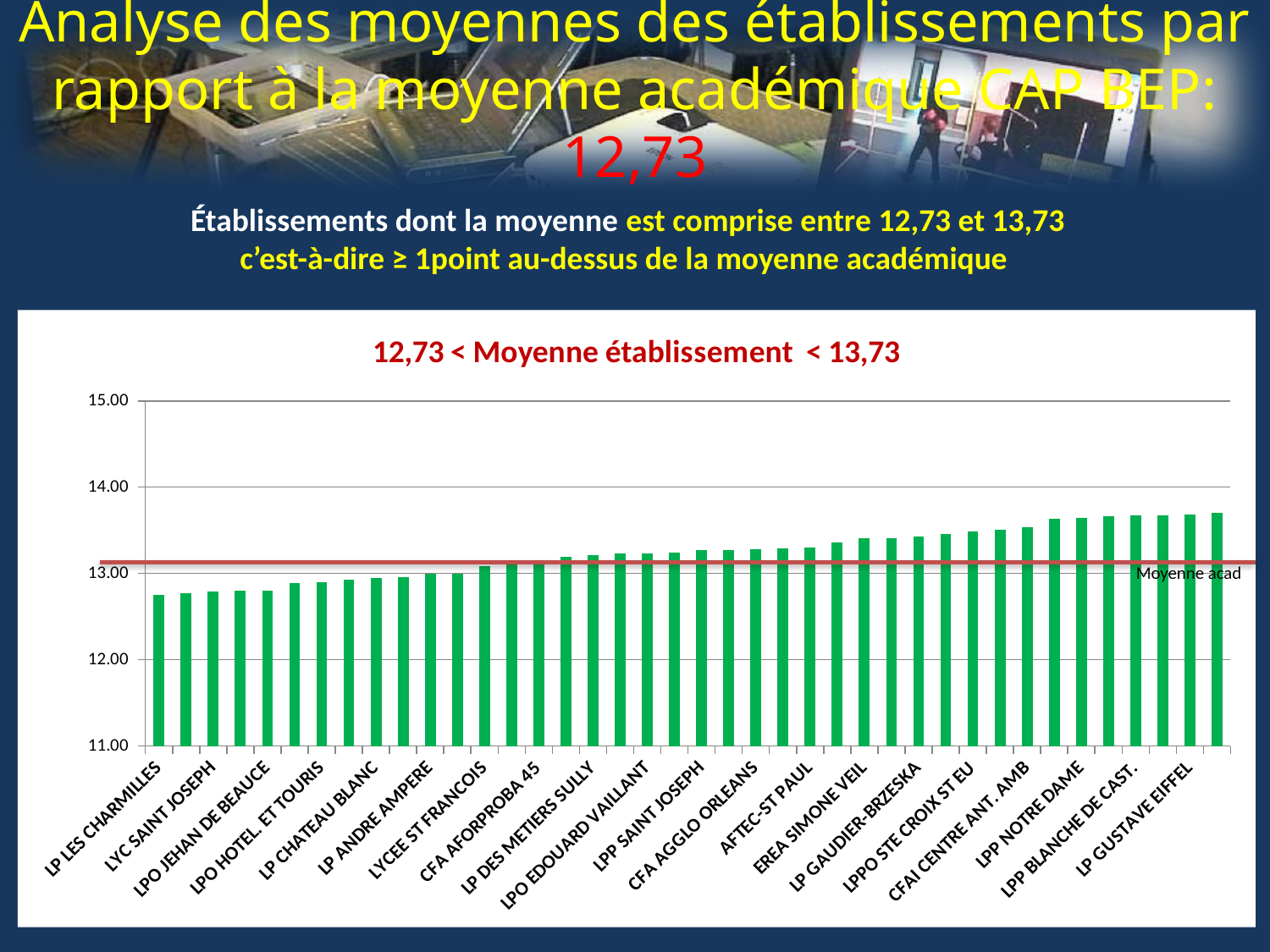
What kind of chart is shown on the slide? bar chart Do the bar values rise or fall from left to right along the x axis? rise Is the value for LP GUSTAVE EIFFEL greater or less than 14.00? less What label is attached to the red horizontal line on the chart? Moyenne acad Is the value for LPP NOTRE DAME greater or less than 14.00? less Is the value for LP LES CHARMILLES greater or less than 13.00? less Which is larger, the value for LPP NOTRE DAME or the value for LPO JEHAN DE BEAUCE? LPP NOTRE DAME Which is larger, the value for LP GUSTAVE EIFFEL or the value for LP LES CHARMILLES? LP GUSTAVE EIFFEL What is the title of the chart? 12,73 < Moyenne établissement < 13,73